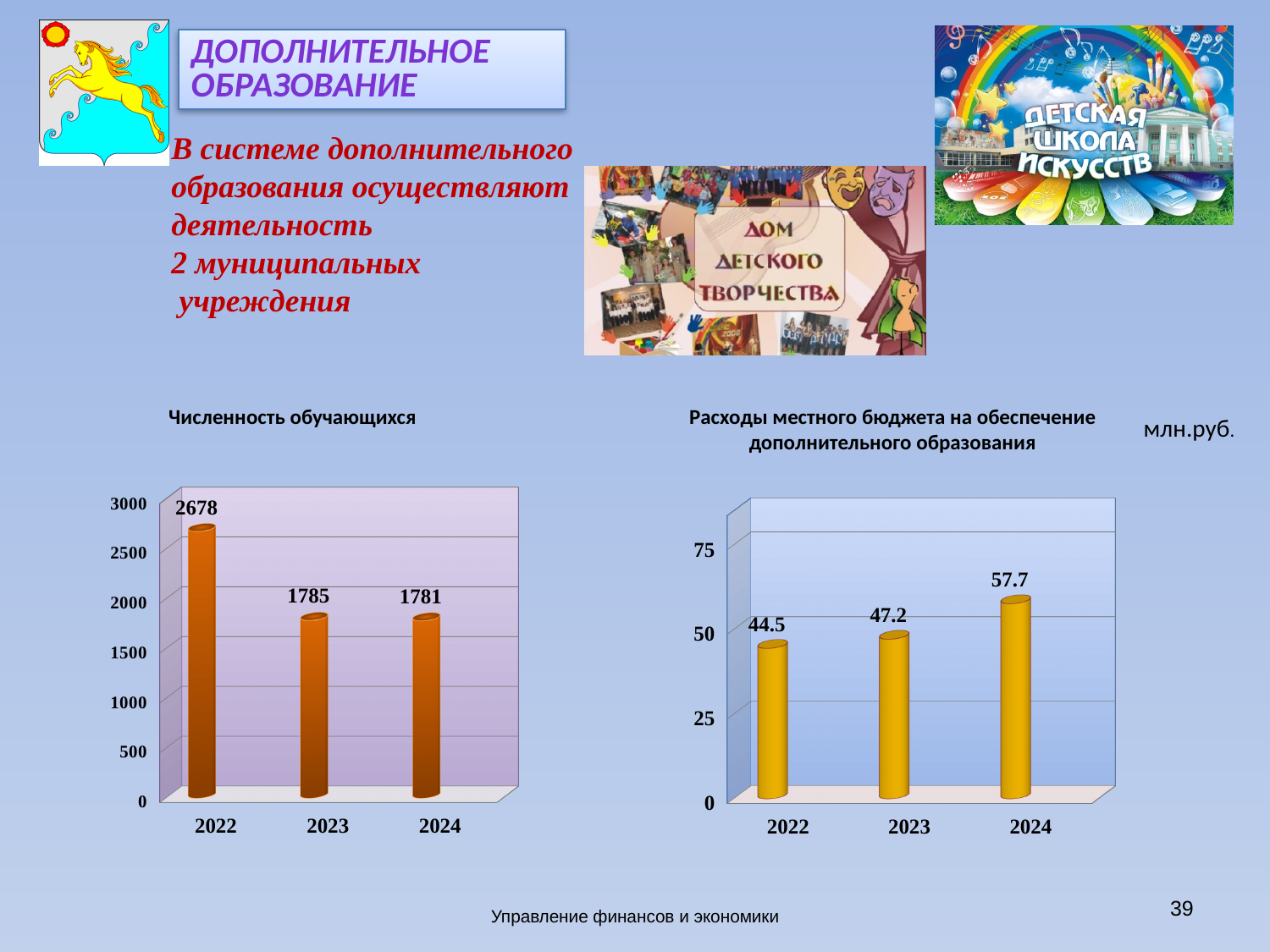
In the 'Расходы местного бюджета на обеспечение дополнительного образования' chart, what is the difference between the values for 2024 and 2022? 13.2 In the 'Численность обучающихся' chart, is the value for 2023 greater or less than 2000? less How many years are shown in the 'Расходы местного бюджета на обеспечение дополнительного образования' chart? 3 In the 'Расходы местного бюджета на обеспечение дополнительного образования' chart, what is the value for 2024? 57.7 In the 'Численность обучающихся' chart, which year has the highest value? 2022 In the 'Расходы местного бюджета на обеспечение дополнительного образования' chart, what is the value for 2023? 47.2 In the 'Численность обучающихся' chart, what is the value for 2024? 1781 In the 'Численность обучающихся' chart, what is the value for 2022? 2678 In the 'Расходы местного бюджета на обеспечение дополнительного образования' chart, do the values rise or fall from 2022 to 2024? rise In the 'Численность обучающихся' chart, what is the difference between the values for 2022 and 2023? 893 What kind of chart is the 'Численность обучающихся' chart? bar chart In the 'Расходы местного бюджета на обеспечение дополнительного образования' chart, which year has the lowest value? 2022